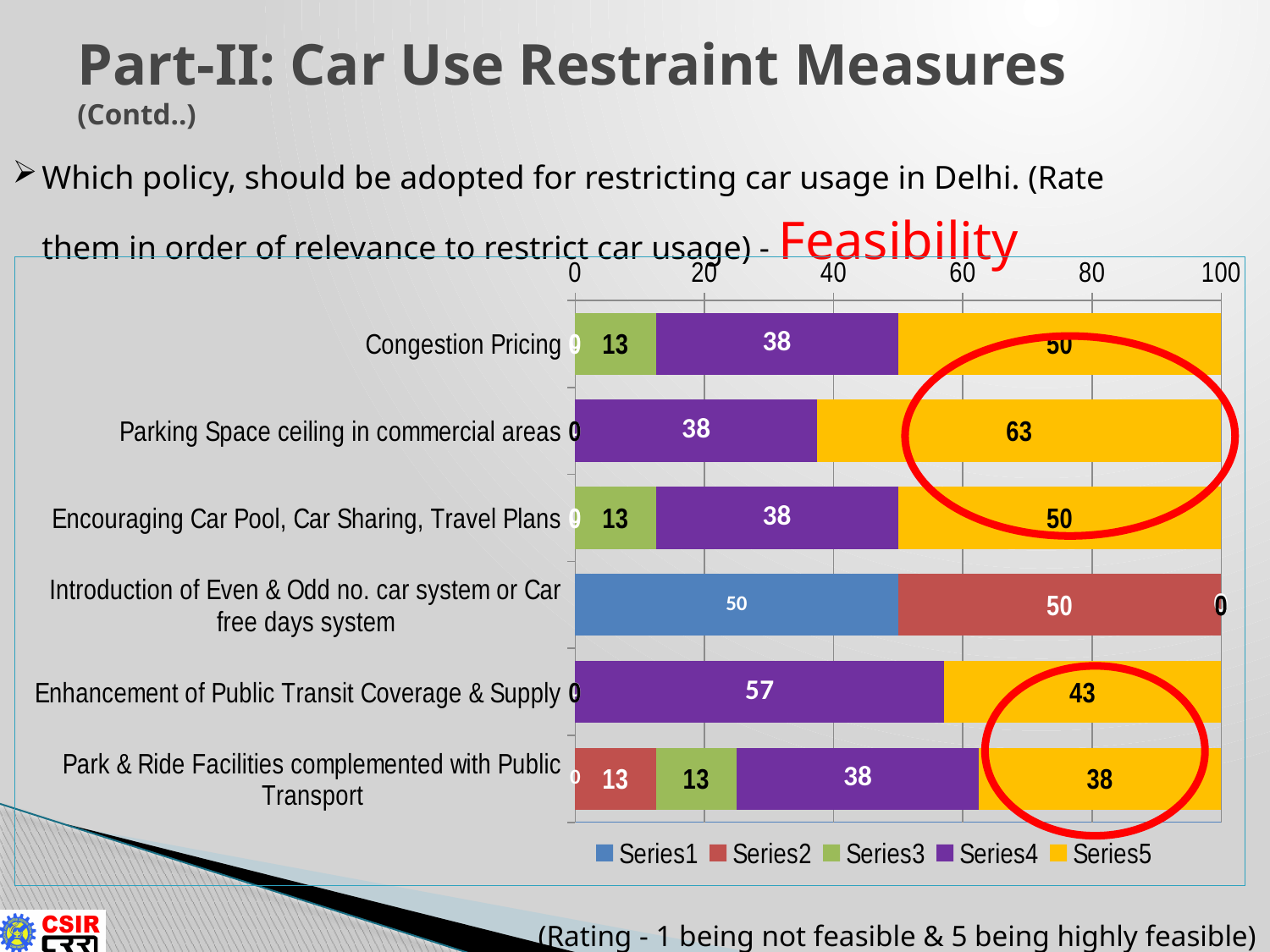
In the Feasibility chart, what is the difference between the Series5 value for Parking Space ceiling in commercial areas and the Series5 value for Park & Ride Facilities complemented with Public Transport? 25 In the Feasibility chart, what is the Series1 value for Introduction of Even & Odd no. car system or Car free days system? 50 In the Feasibility chart, what is the Series5 value for Parking Space ceiling in commercial areas? 63 What kind of chart is the Feasibility chart? Stacked bar chart What is the title of the chart on the slide? Feasibility How many series does the legend of the Feasibility chart list? 5 In the Feasibility chart, which category has the highest Series5 value? Parking Space ceiling in commercial areas In the Feasibility chart, what is the Series4 value for Enhancement of Public Transit Coverage & Supply? 57 In the Feasibility chart, which is larger: the Series4 value for Enhancement of Public Transit Coverage & Supply or the Series4 value for Congestion Pricing? Enhancement of Public Transit Coverage & Supply In the Feasibility chart, what is the Series3 value for Park & Ride Facilities complemented with Public Transport? 13 In the Feasibility chart, which category has the highest Series4 value? Enhancement of Public Transit Coverage & Supply How many categories (policies) are shown in the Feasibility chart? 6